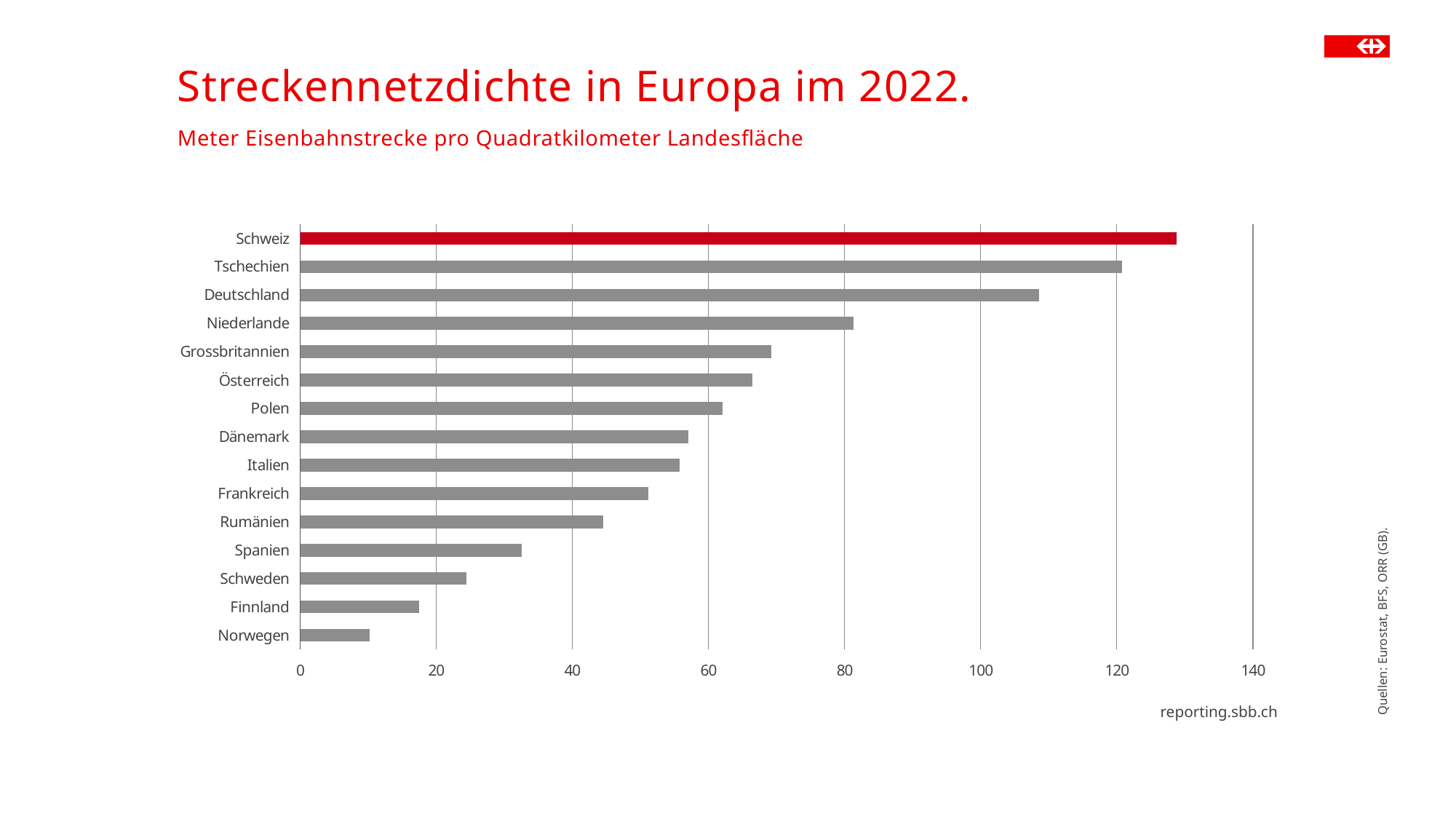
Which country's bar is highlighted in red? Schweiz Is the value for Schweiz greater or less than 120? greater Is the value for Spanien greater or less than 40? less Which country has the highest value in the chart? Schweiz Is the value for Dänemark greater or less than 60? less Which has a larger value, Deutschland or Niederlande? Deutschland What kind of chart is shown on the slide? bar chart How many countries are shown in the chart? 15 Which country has the lowest value in the chart? Norwegen Which has a larger value, Spanien or Schweden? Spanien